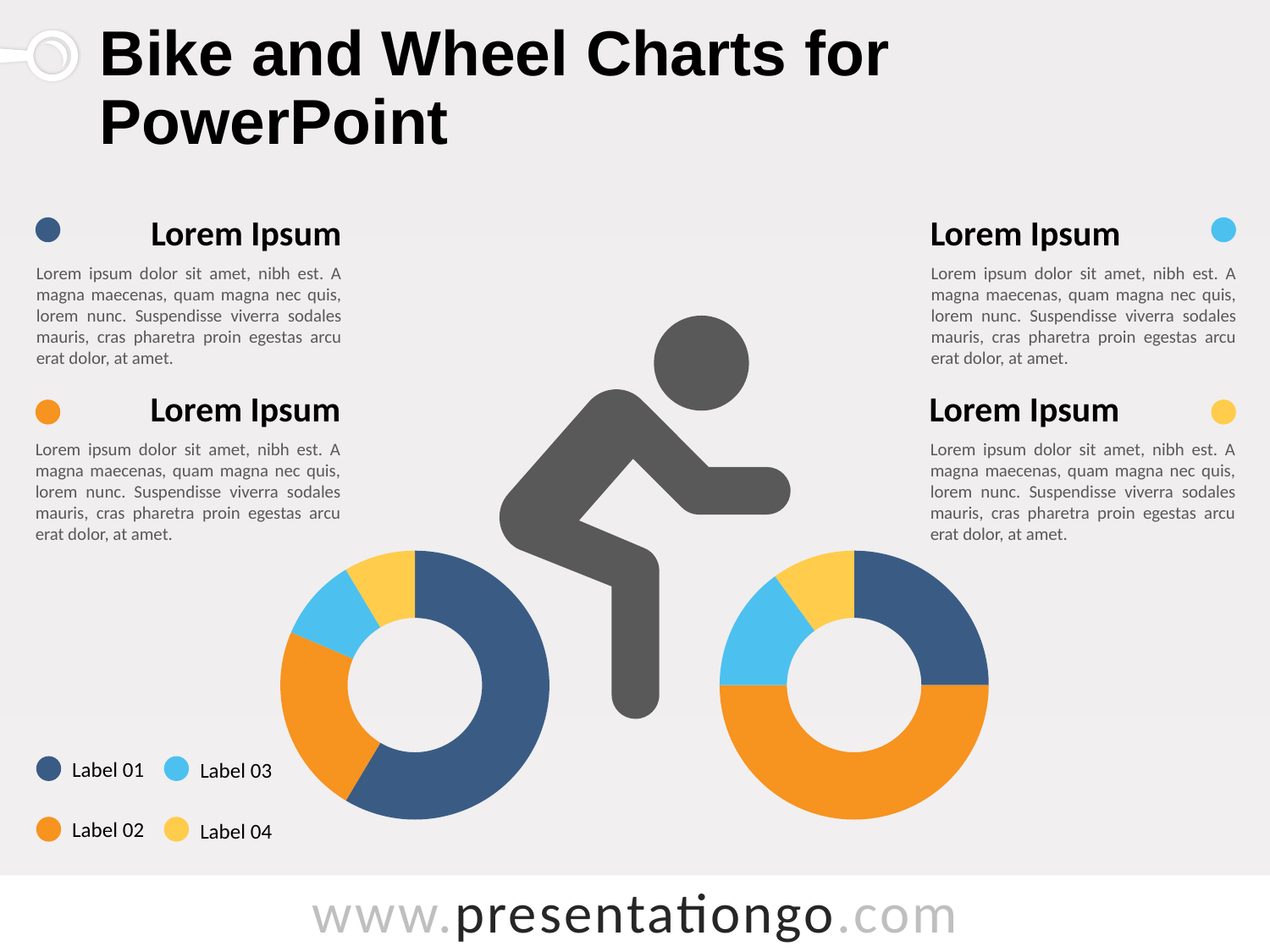
How many slices does the left wheel chart have? 4 How many slices does the right wheel chart have? 4 In the right wheel chart, which slice is larger, Label 03 or Label 04? Label 03 In the left wheel chart, which label has the largest slice? Label 01 What kind of chart is the left wheel chart? doughnut chart In the right wheel chart, which slice is larger, Label 02 or Label 01? Label 02 In the left wheel chart, which slice is larger, Label 01 or Label 02? Label 01 In the right wheel chart, which label has the smallest slice? Label 04 In the right wheel chart, which label has the largest slice? Label 02 How many entries does the legend list? 4 What kind of chart is the right wheel chart? doughnut chart Which colour represents Label 02 in the legend? orange